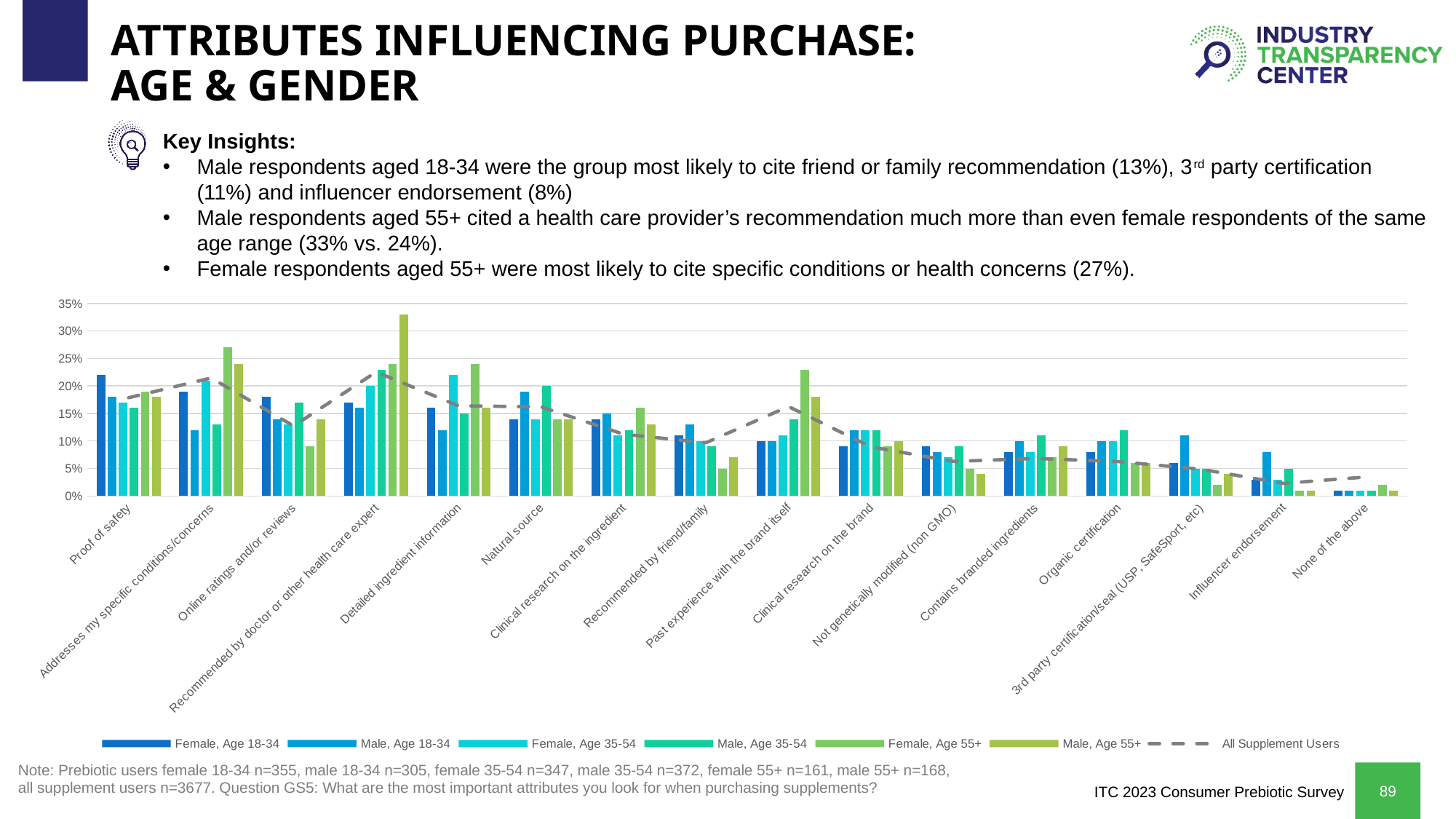
Is the value for Female, Age 55+ on 'Past experience with the brand itself' greater or less than 20%? greater What kind of chart is shown on the slide? combination bar and line chart Which category has the tallest bar in the chart? Recommended by doctor or other health care expert For 'Recommended by doctor or other health care expert', which series has the highest bar? Male, Age 55+ How many attribute categories are shown along the x axis of the chart? 16 Is the value for Male, Age 55+ on 'Recommended by doctor or other health care expert' greater or less than 30%? greater Which category has the lowest bars in the chart? None of the above Do the bar values generally rise or fall moving from left to right along the x axis? fall Is the value for Female, Age 18-34 on 'Proof of safety' greater or less than 20%? greater Which legend entry is drawn as a dashed grey line rather than bars? All Supplement Users For 'Proof of safety', which is larger: Female, Age 18-34 or Male, Age 18-34? Female, Age 18-34 How many entries does the chart legend list? 7